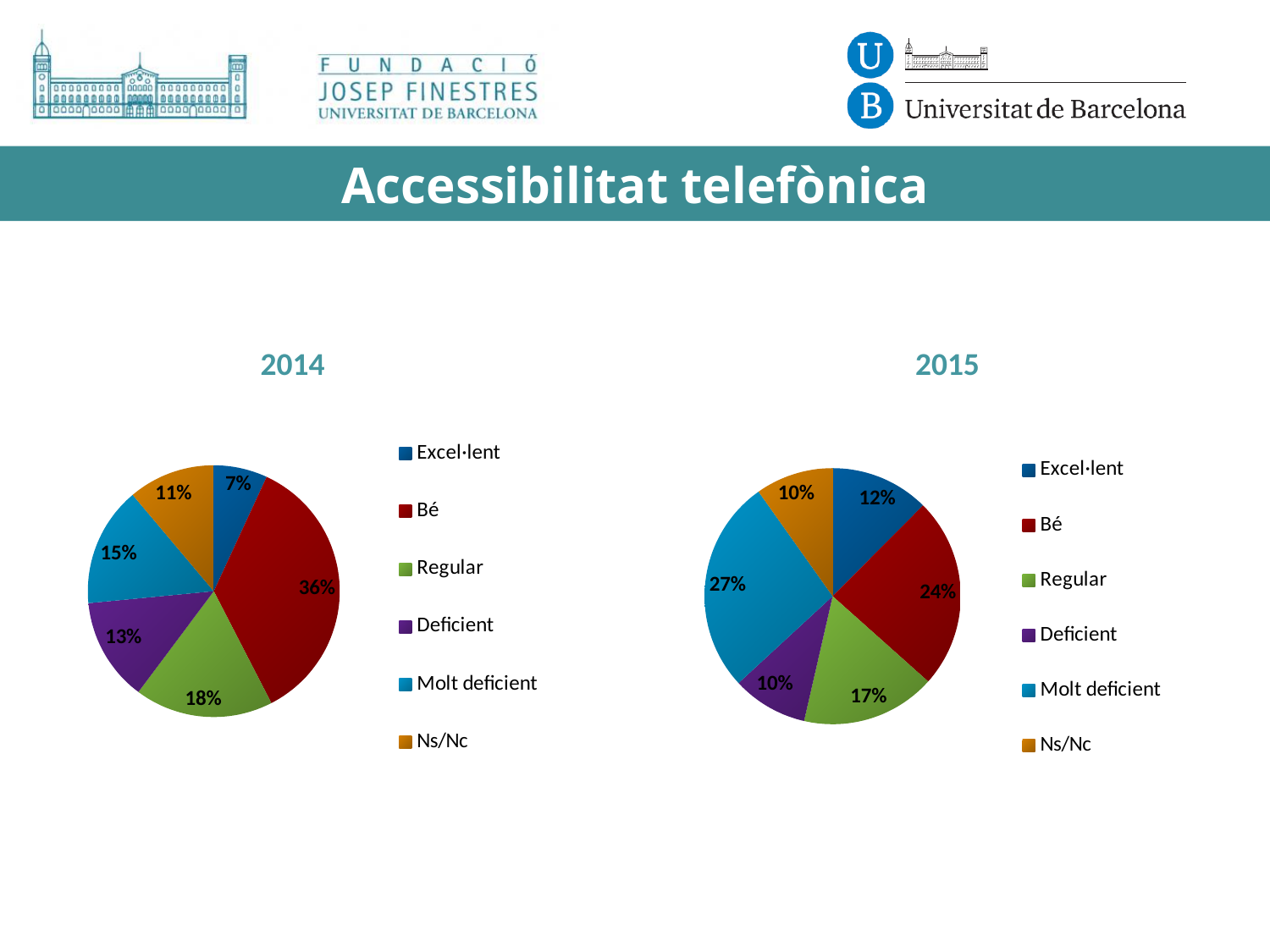
In the 2014 chart, what share does Bé have? 36% In the 2015 chart, which category has the largest slice? Molt deficient In the 2014 chart, which category has the largest slice? Bé In the 2015 chart, what share does Regular have? 17% In the 2014 chart, what share does Excel·lent have? 7% What kind of chart is the 2014 chart? Pie chart In the 2014 chart, which category has the smallest slice? Excel·lent In the 2015 chart, which is larger, Bé or Regular? Bé In the 2015 chart, what share does Molt deficient have? 27% In the 2014 chart, what is the difference between the Bé and Regular shares? 18% How many categories does the legend of the 2015 chart list? 6 What is the title of the chart on the right? 2015